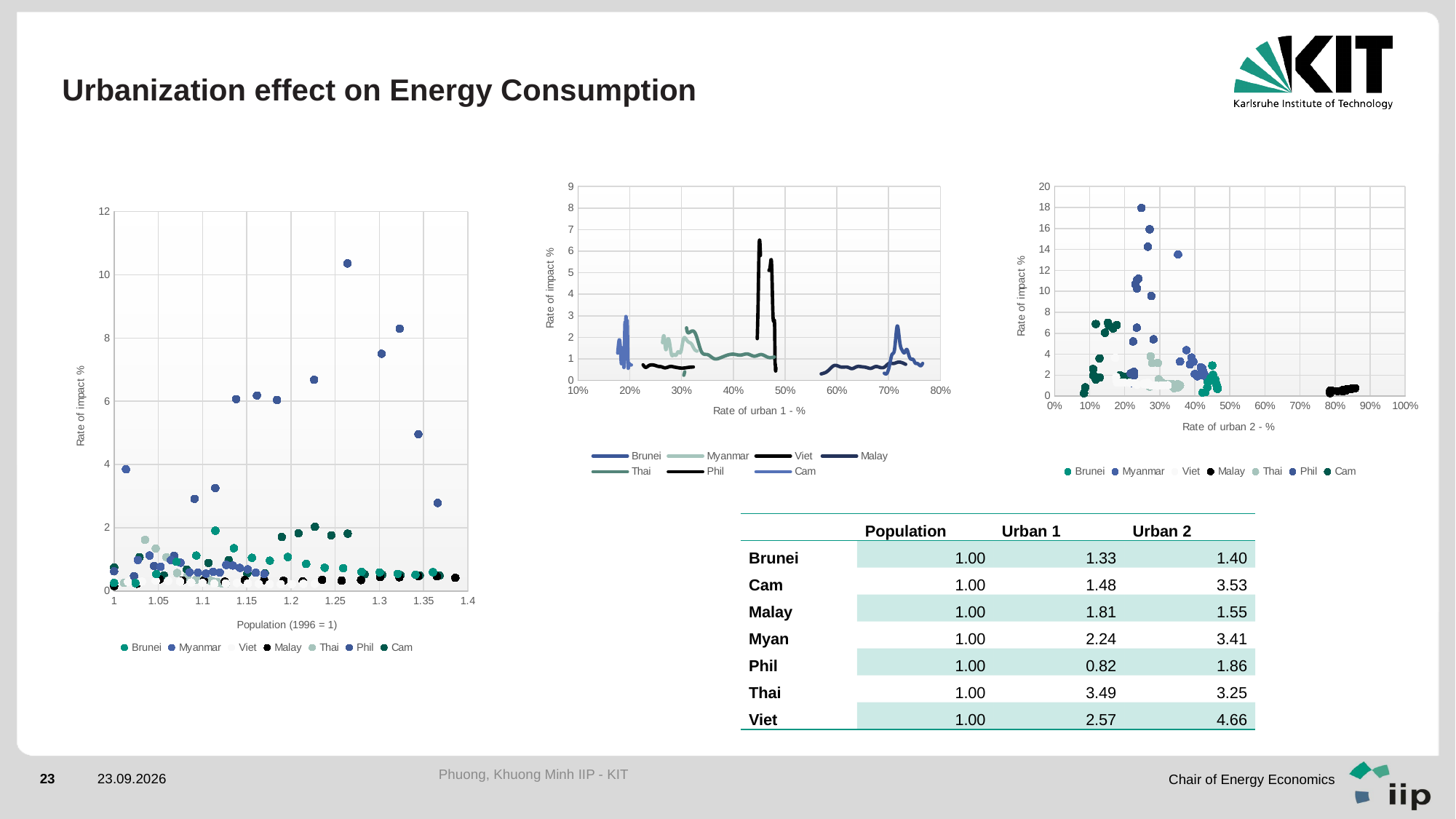
What kind of chart is the middle chart (Rate of urban 1)? line chart In the middle chart (Rate of urban 1), is the peak of the Malay line greater or less than 3? less In the right chart (Rate of urban 2), is the highest Myanmar point greater or less than 16? less What is the x-axis title of the right chart? Rate of urban 2 - % What kind of chart is the left chart (Population)? scatter chart In the right chart (Rate of urban 2), which series has the highest plotted point? Phil How many series does the legend of the middle chart (Rate of urban 1) list? 7 What is the x-axis title of the left chart? Population (1996 = 1) In the left chart (Population), is the highest Myanmar point greater or less than 10? less In the left chart (Population), which series has the highest plotted point? Phil How many series does the legend of the left chart (Population) list? 7